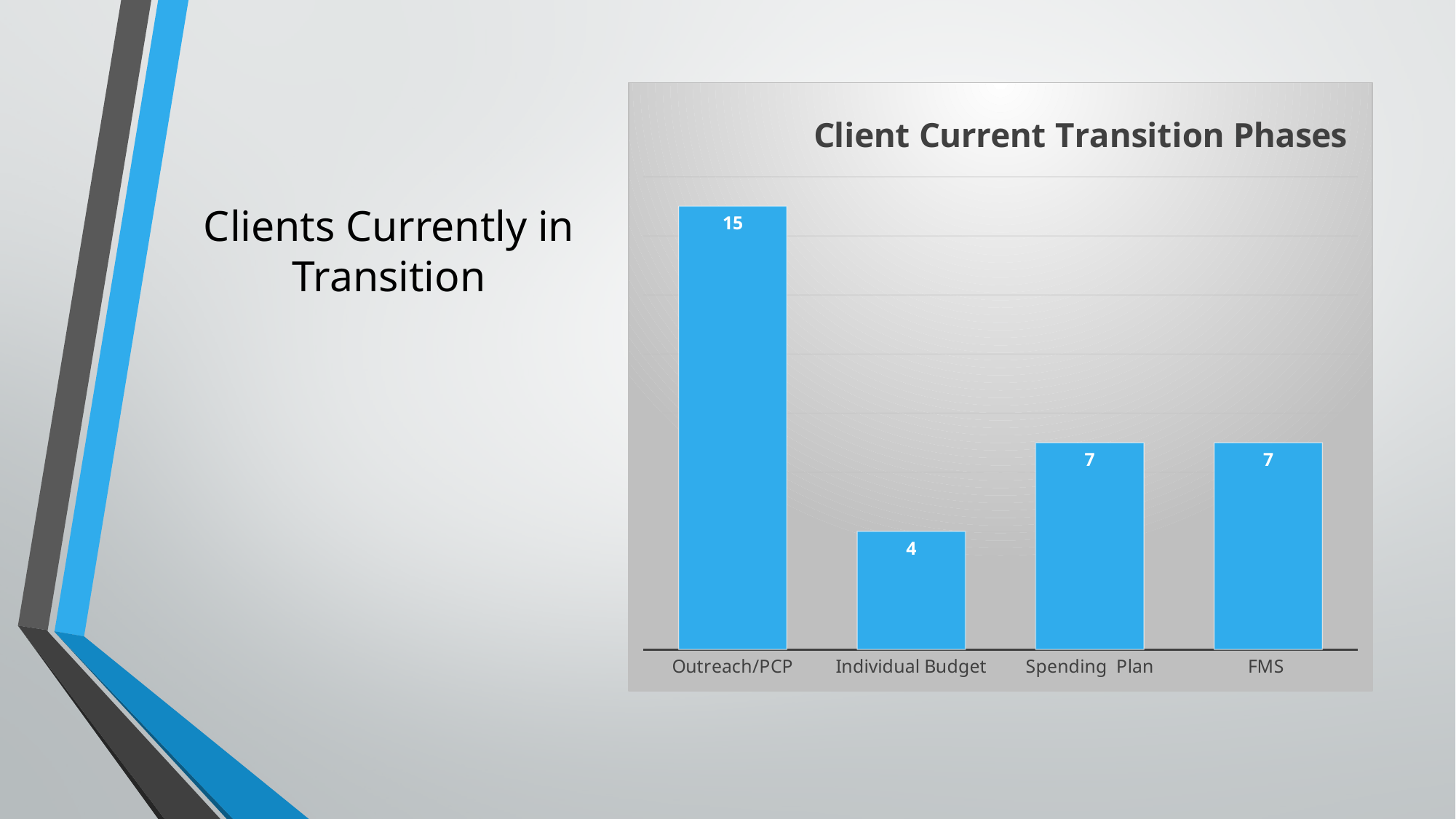
What is the difference between the values for Outreach/PCP and Individual Budget? 11 What kind of chart is shown on the slide? Bar chart What is the value for Individual Budget? 4 Which is larger, the value for Outreach/PCP or the value for FMS? Outreach/PCP Which category has the highest value? Outreach/PCP What is the title of the chart? Client Current Transition Phases How many categories are shown on the x axis? 4 What is the value for Spending Plan? 7 What is the difference between the values for Spending Plan and Individual Budget? 3 What is the value for FMS? 7 Which category has the lowest value? Individual Budget What is the value for Outreach/PCP? 15